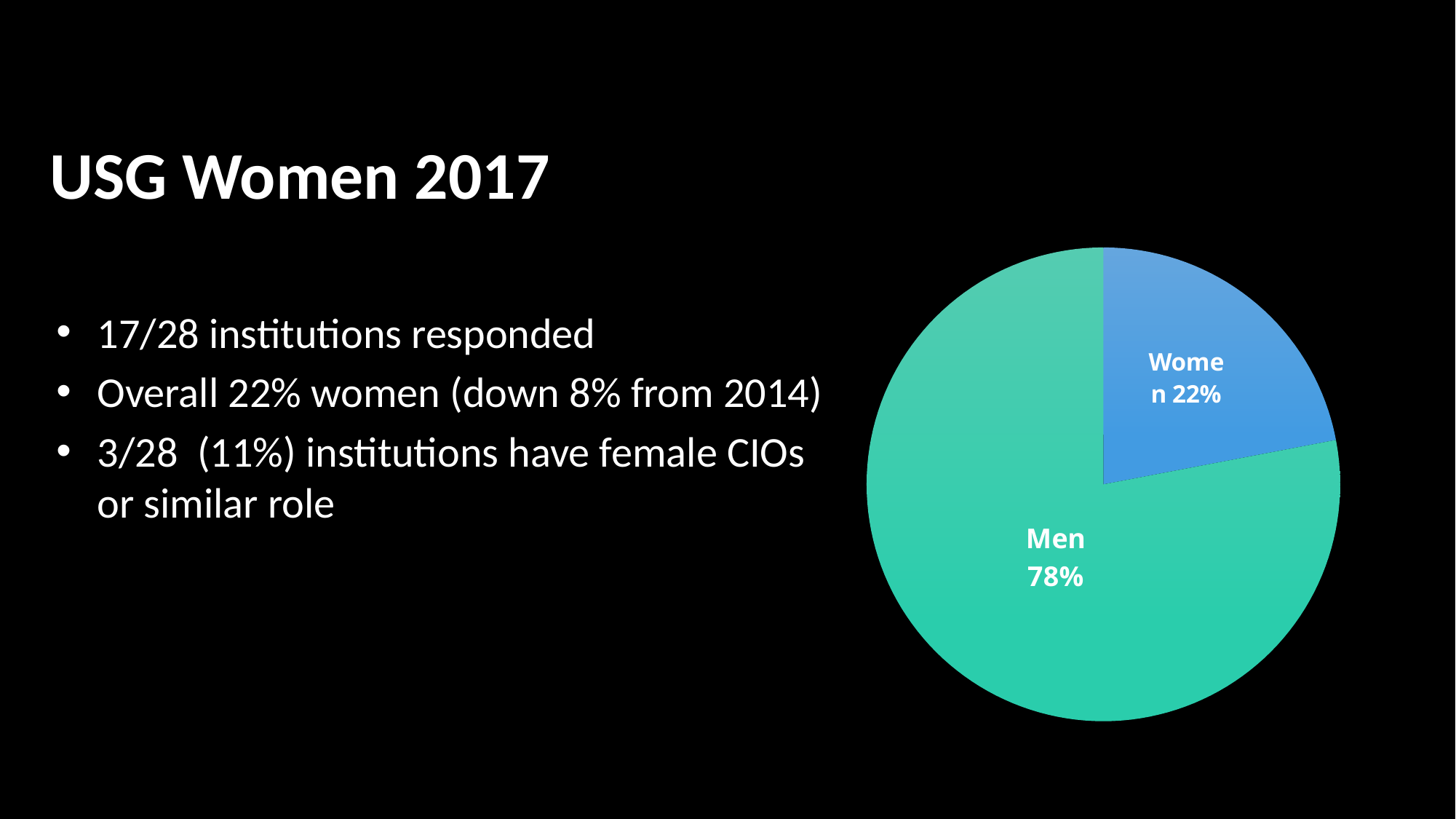
Which slice is larger, Men or Women? Men What colour is the Women slice of the pie chart? blue What kind of chart is shown on the slide? pie chart Which slice of the pie chart is the largest? Men What share of the pie chart is labelled Women? 22% What is the difference in percentage points between the Men and Women slices? 56% Which slice of the pie chart is the smallest? Women How many slices does the pie chart have? 2 Is the share for Women greater or less than 50%? less What colour is the Men slice of the pie chart? green What share of the pie chart is labelled Men? 78%